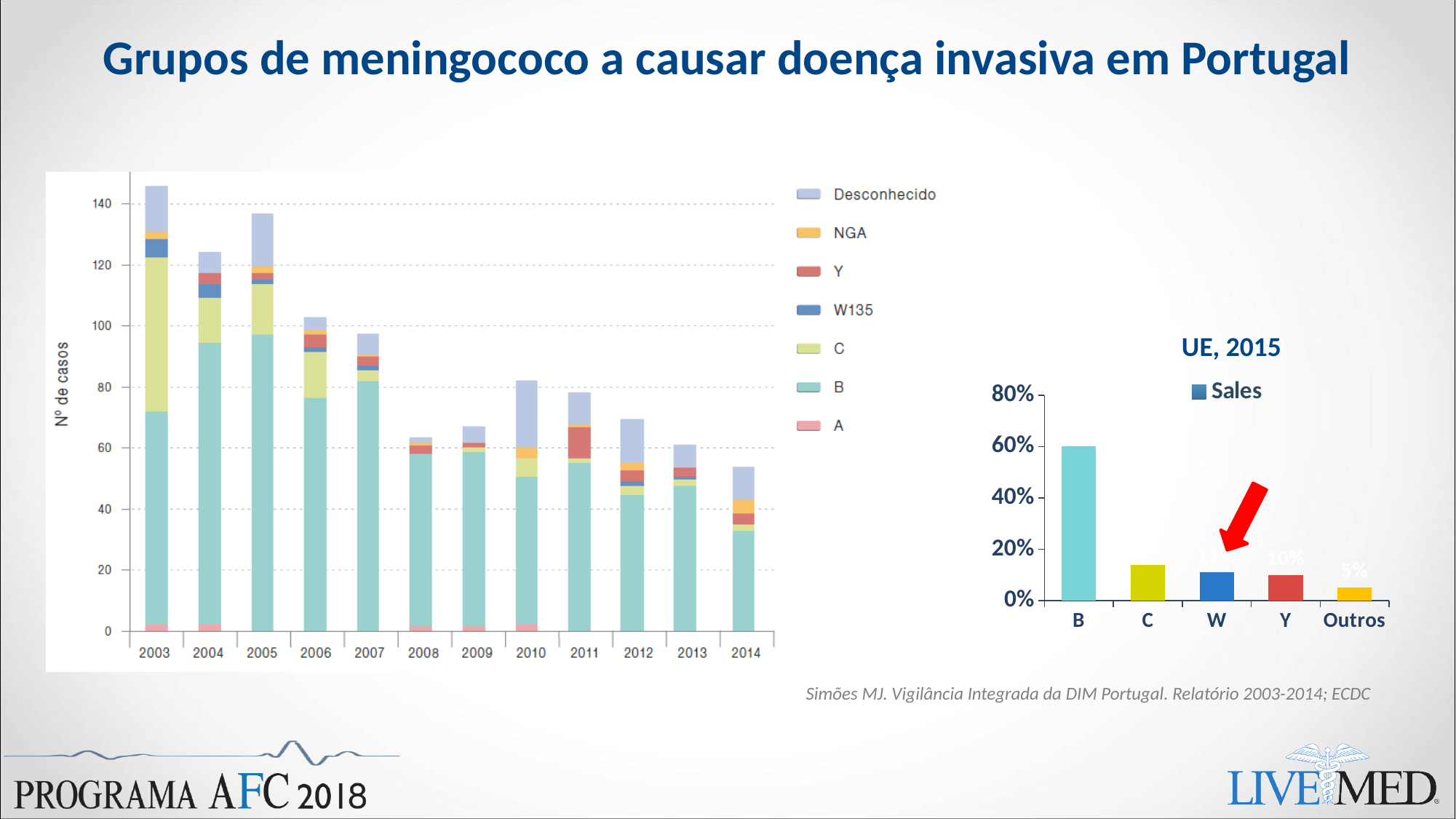
In the left chart, is the total for 2014 greater or less than 60? less How many years are shown on the x axis of the left chart? 12 In the left chart, is the total for 2003 greater or less than 140? greater What kind of chart is the left chart showing Nº de casos by year? bar chart In the left chart, do the total cases generally rise or fall from 2003 to 2014? fall In the UE, 2015 chart, which category has the highest value? B In the UE, 2015 chart, what is the value for Outros? 5% In the left chart, which year has the lowest total number of cases? 2014 In the UE, 2015 chart, is the value for B greater or less than 40%? greater In the left chart, which year has the highest total number of cases? 2003 In the UE, 2015 chart, what is the value for Y? 10% How many series does the legend of the left chart list? 7